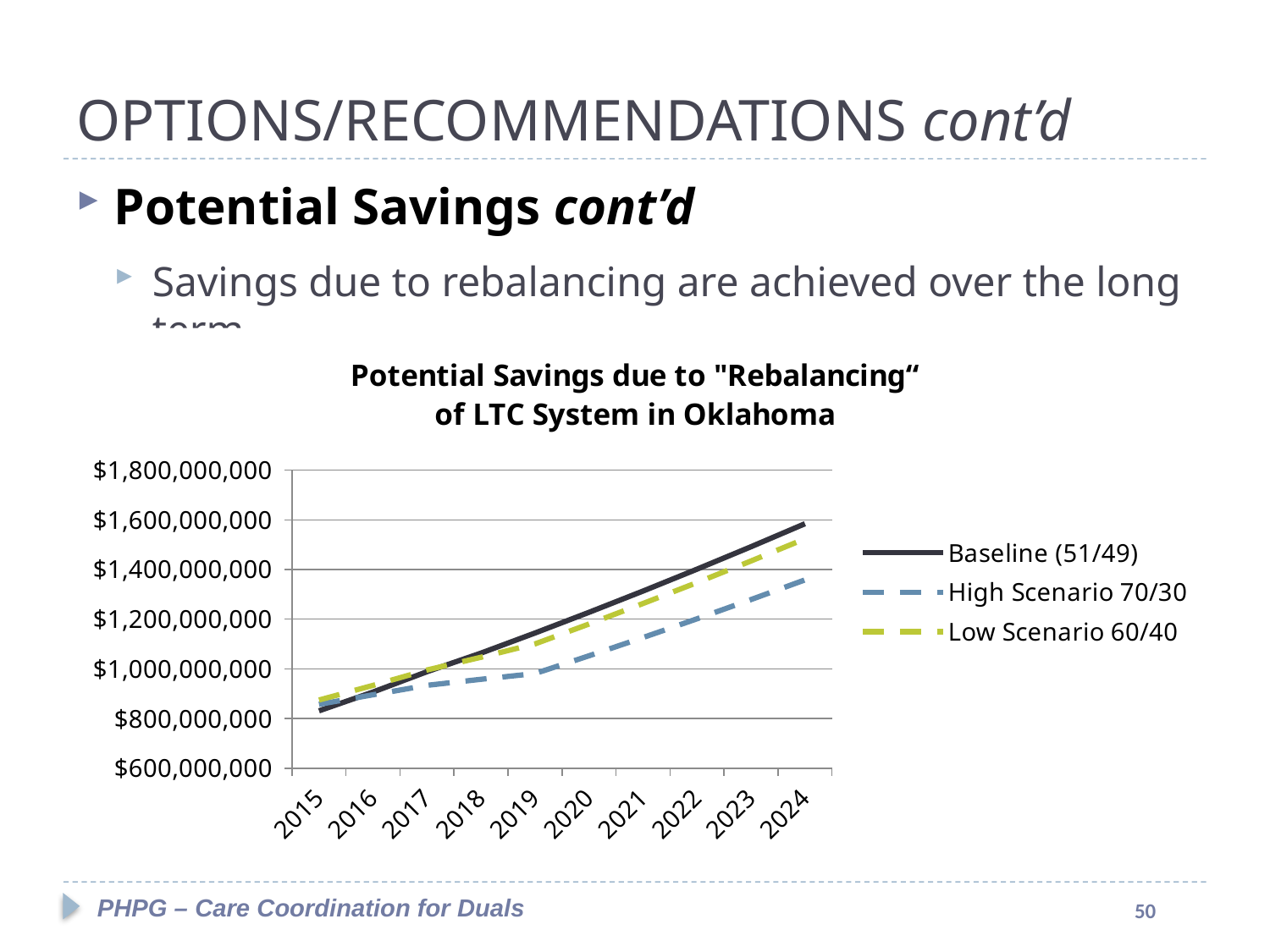
In 2024, which is larger: the Baseline (51/49) value or the High Scenario 70/30 value? Baseline (51/49) Which series is shown as a solid dark line in the chart? Baseline (51/49) What kind of chart is shown on the slide? line chart Is the Baseline (51/49) value for 2024 greater or less than $1,400,000,000? greater Is the High Scenario 70/30 value for 2024 greater or less than $1,400,000,000? less Does the Baseline (51/49) series rise or fall from 2015 to 2024? rise Which series has the highest value in 2024? Baseline (51/49) Which series has the lowest value in 2024? High Scenario 70/30 How many years are shown on the x axis of the chart? 10 Is the Baseline (51/49) value for 2015 greater or less than $1,000,000,000? less What is the title of the chart? Potential Savings due to "Rebalancing" of LTC System in Oklahoma How many series does the chart legend list? 3